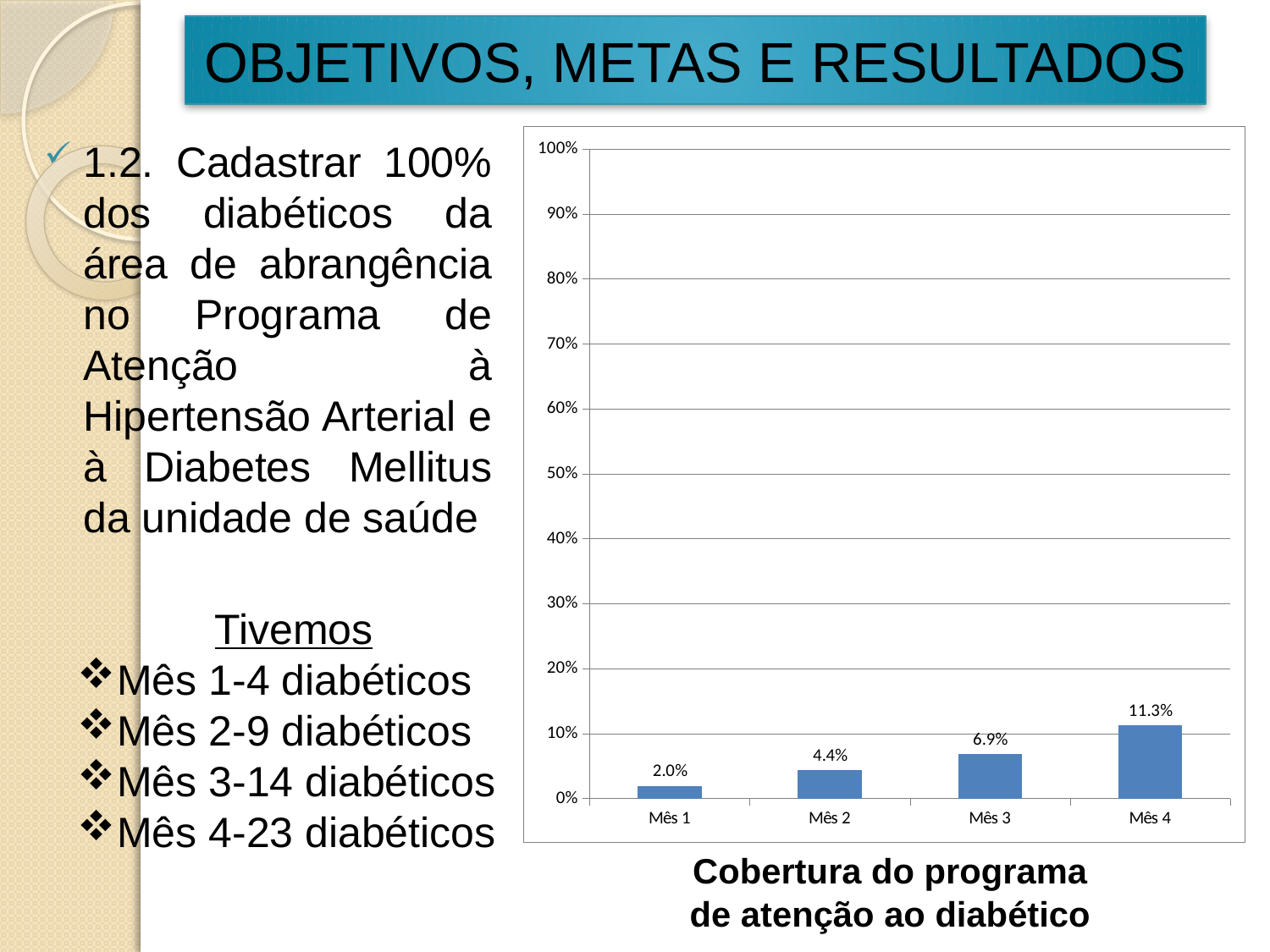
What kind of chart is shown on the slide? bar chart Is the value for Mês 4 greater or less than 10%? greater Do the values rise or fall from Mês 1 to Mês 4? rise What is the value for Mês 3? 6.9% Which month has the highest value? Mês 4 What is the value for Mês 4? 11.3% Which month has the lowest value? Mês 1 What is the difference between the values for Mês 4 and Mês 1? 9.3% What is the value for Mês 1? 2.0% What is the value for Mês 2? 4.4% How many months are shown on the x axis? 4 Which is larger, the value for Mês 2 or the value for Mês 3? Mês 3